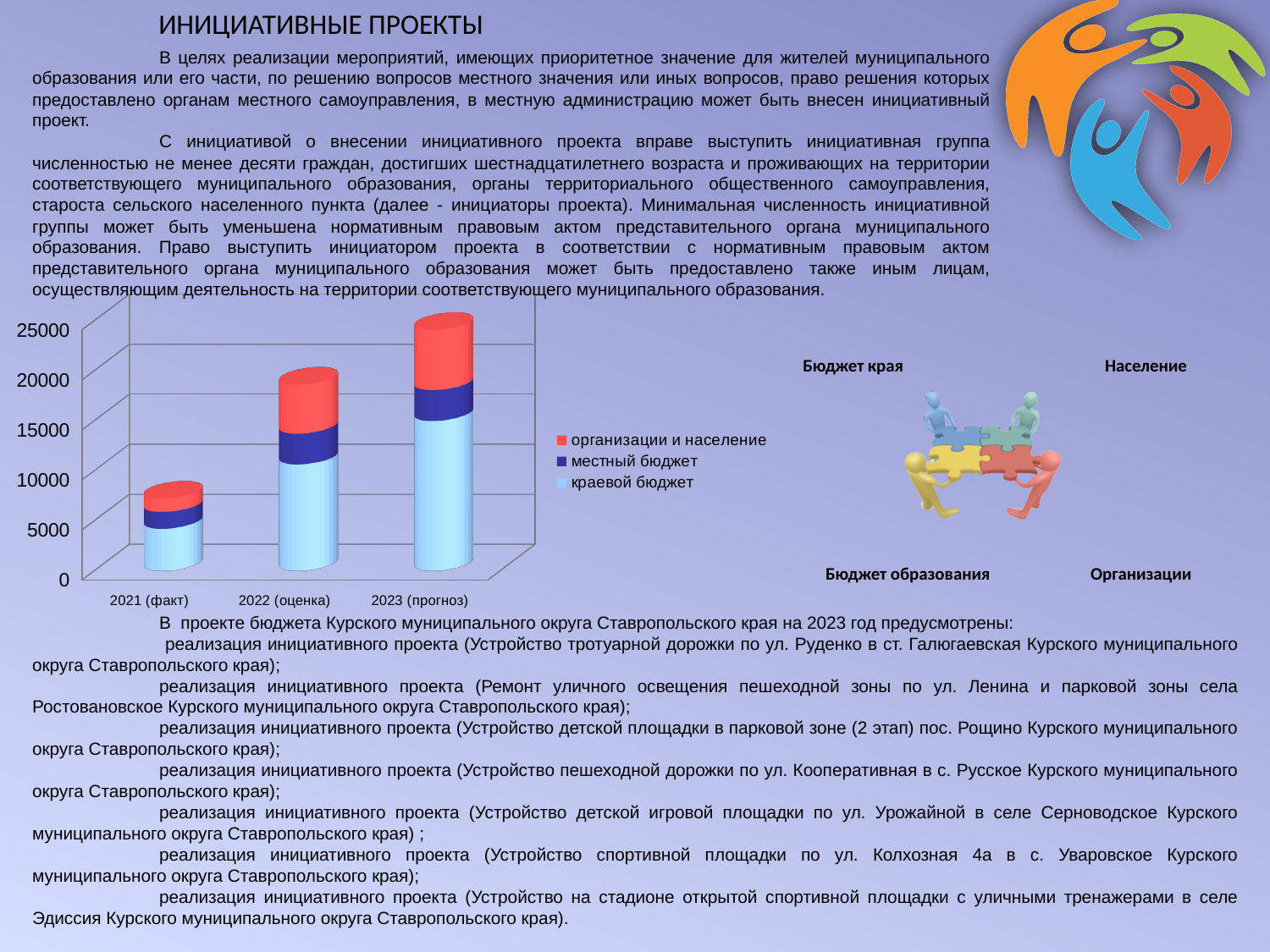
Is the total of the stacked bar for 2021 (факт) greater or less than 10000? less Which category has the shortest stacked bar? 2021 (факт) Which series is shown in red in the chart legend? организации и население How many series does the chart legend list? 3 How many categories are shown on the x axis of the chart? 3 Is the total of the stacked bar for 2023 (прогноз) greater or less than 20000? greater Which stacked bar is taller, 2022 (оценка) or 2021 (факт)? 2022 (оценка) Is the value of краевой бюджет for 2023 (прогноз) greater or less than 10000? greater Which category has the tallest stacked bar? 2023 (прогноз) What kind of chart is shown on the slide? stacked bar chart Do the total bar heights rise or fall from 2021 (факт) to 2023 (прогноз)? rise